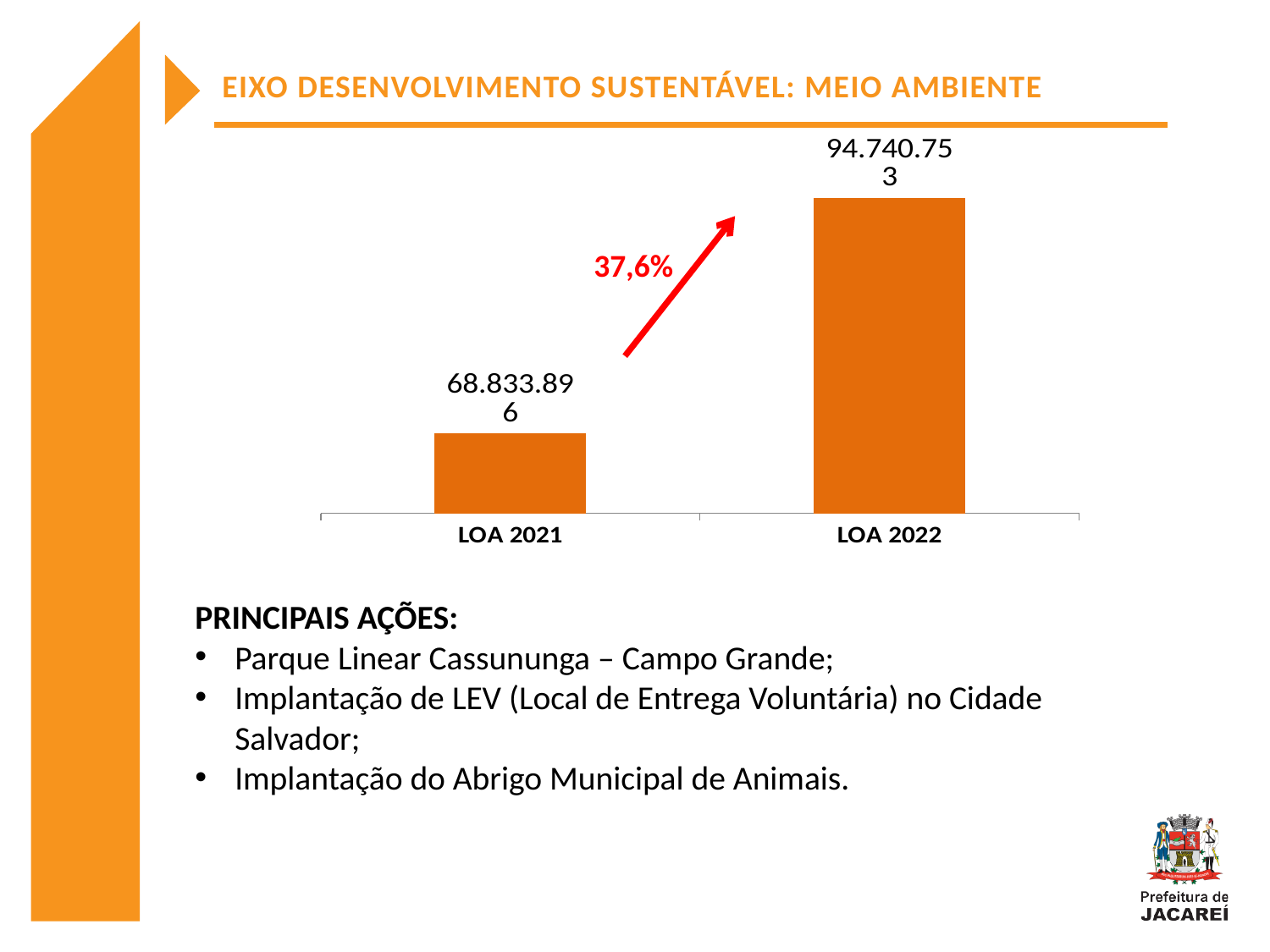
What percentage change is annotated on the arrow between the two bars? 37,6% What is the value shown for LOA 2021? 68.833.896 Do the values rise or fall from LOA 2021 to LOA 2022? Rise Which category has the highest value? LOA 2022 What colour are the bars in the chart? Orange Which category has the lowest value? LOA 2021 What is the value shown for LOA 2022? 94.740.753 How many categories are shown on the x axis? 2 What kind of chart is shown on the slide? Bar chart What is the difference between the LOA 2022 and LOA 2021 values? 25.906.857 Which is larger, the value for LOA 2021 or LOA 2022? LOA 2022